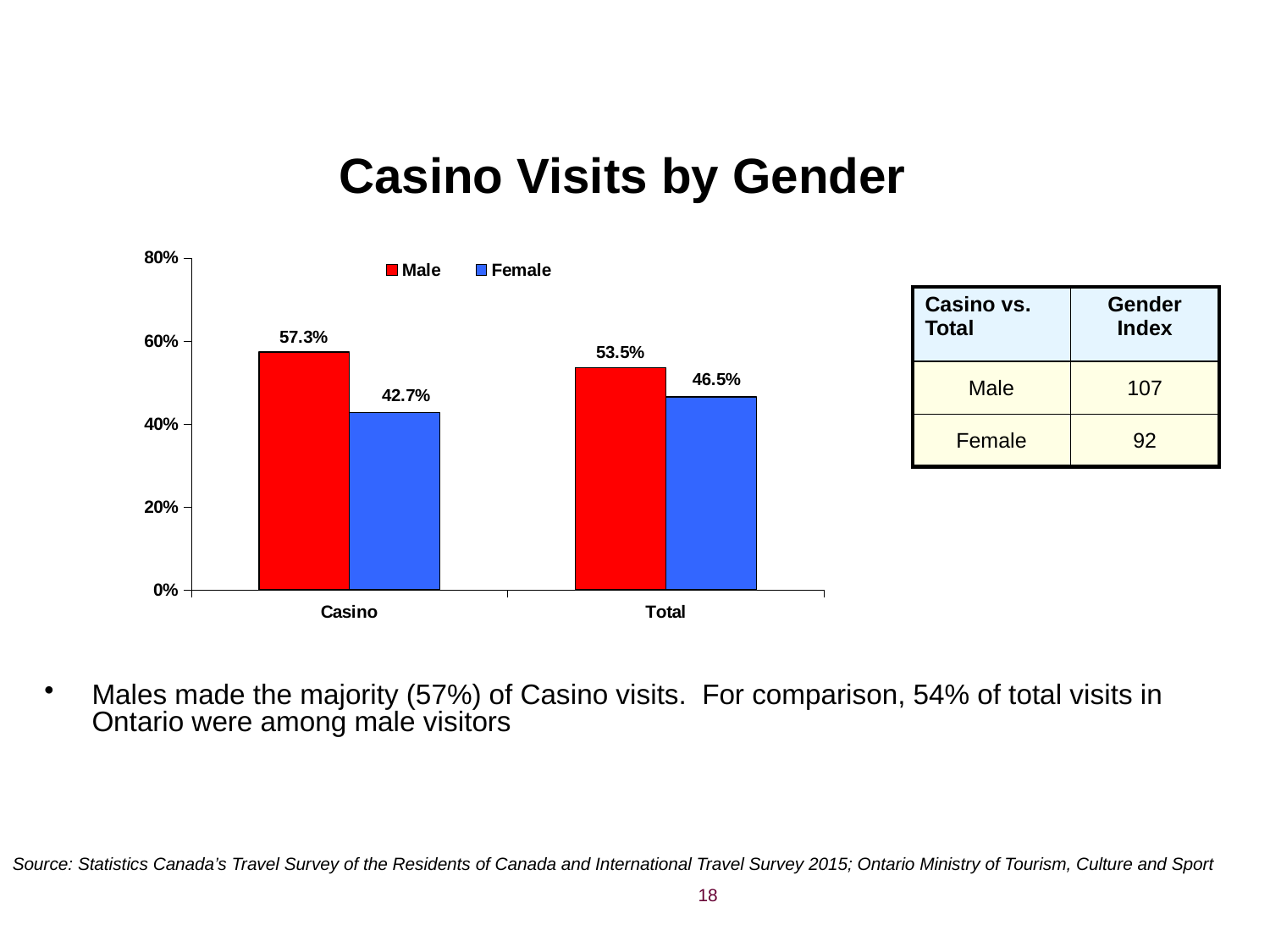
Which category has the highest Male value? Casino What is the Female value for Casino? 42.7% How many series does the legend list? 2 Which category has the lowest Female value? Casino What is the Male value for Casino? 57.3% What is the difference between the Male and Female values for Casino? 14.6% What kind of chart is shown on the slide? Bar chart What is the difference between the Male values for Casino and Total? 3.8% How many categories are shown on the x axis? 2 What is the Female value for Total? 46.5% Which is larger for Total, the Male value or the Female value? Male What is the Male value for Total? 53.5%